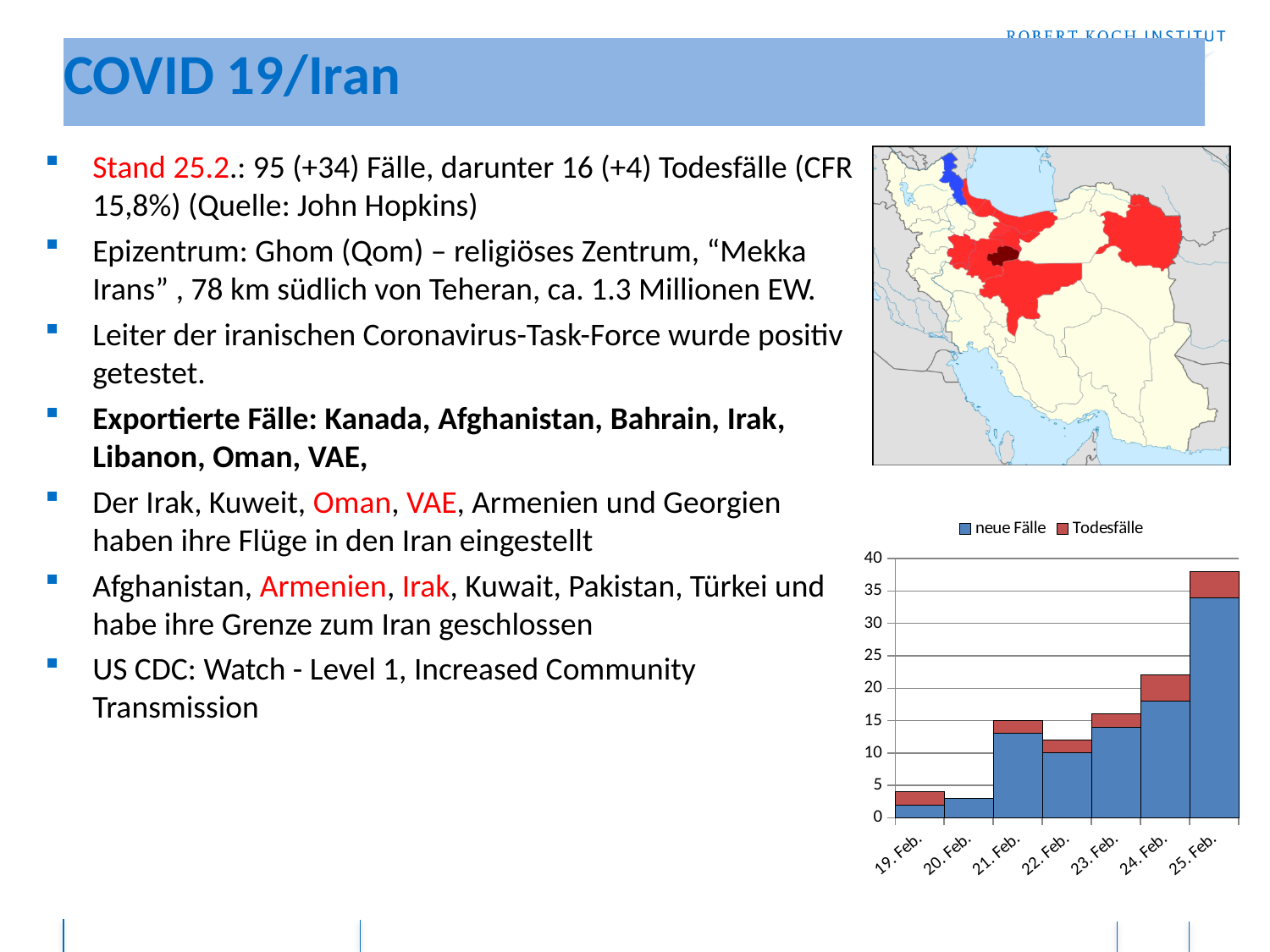
Which series are listed in the chart legend? neue Fälle and Todesfälle What kind of chart is shown on the slide? stacked bar chart Do the total bars generally rise or fall from 21. Feb. to 25. Feb.? rise On which date is the total stacked bar highest? 25. Feb. Is the total bar for 22. Feb. greater or less than 15? less How many dates are shown on the x axis of the chart? 7 Is the total bar for 20. Feb. greater or less than 5? less Which date has the larger total bar, 21. Feb. or 22. Feb.? 21. Feb. Which colour represents Todesfälle in the chart? red Is the total bar for 24. Feb. greater or less than 25? less How many series does the chart legend list? 2